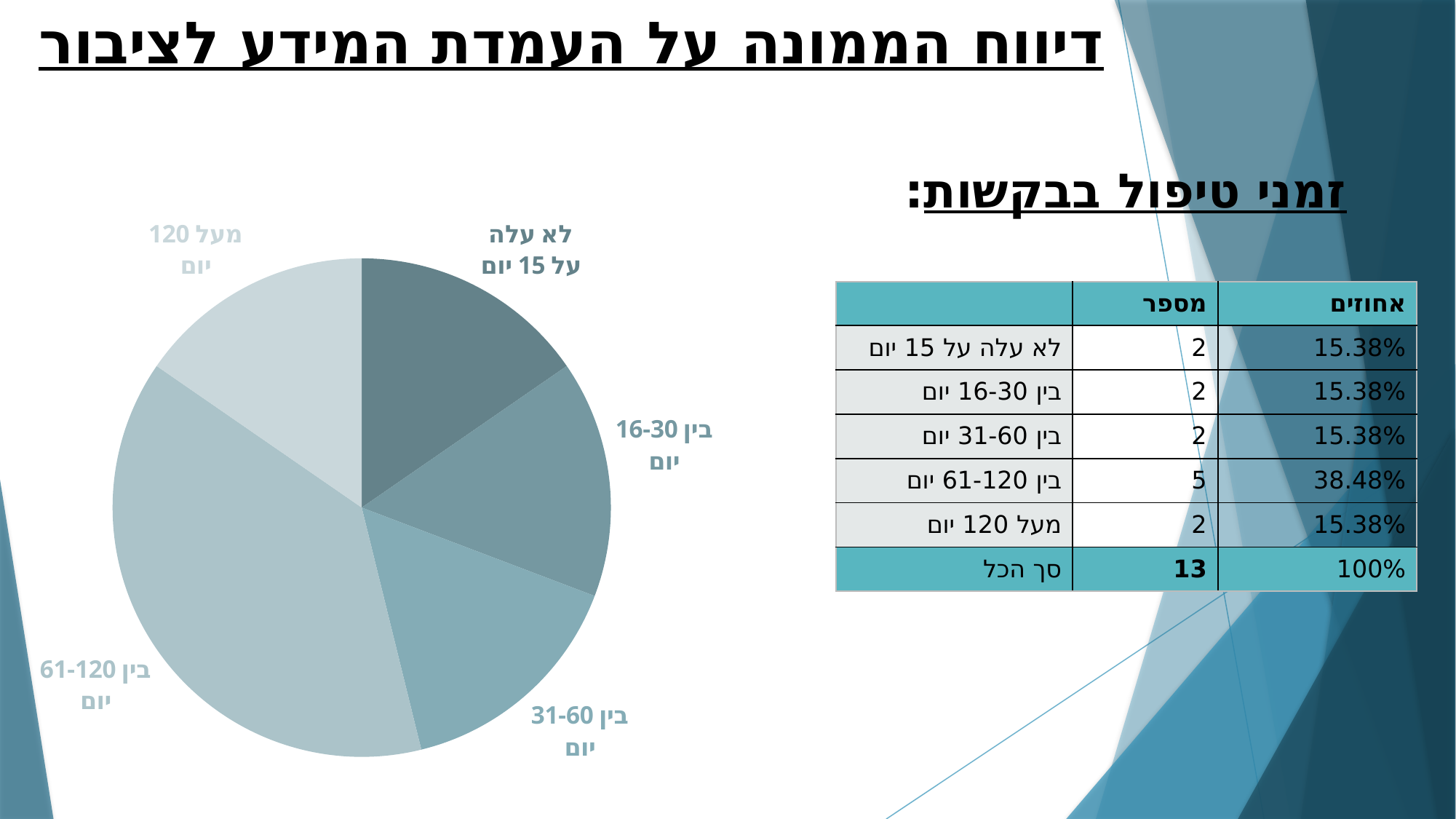
What is the heading above the pie chart and table on the slide? זמני טיפול בבקשות: According to the table on the slide, what is the count (מספר) for בין 61-120 יום? 5 How many slices does the pie chart have? 5 What is the difference between the count for בין 61-120 יום and the count for בין 31-60 יום in the table? 3 Which category has the largest slice in the pie chart? בין 61-120 יום According to the table on the slide, what percentage share does בין 61-120 יום have? 38.48% What is the total number of requests (סך הכל) shown in the table? 13 Which slice is larger in the pie chart: בין 61-120 יום or בין 16-30 יום? בין 61-120 יום According to the table on the slide, what is the count (מספר) for לא עלה על 15 יום? 2 What kind of chart is shown on the slide? pie chart According to the table on the slide, what percentage share does מעל 120 יום have? 15.38% Which slice is larger in the pie chart: בין 61-120 יום or מעל 120 יום? בין 61-120 יום